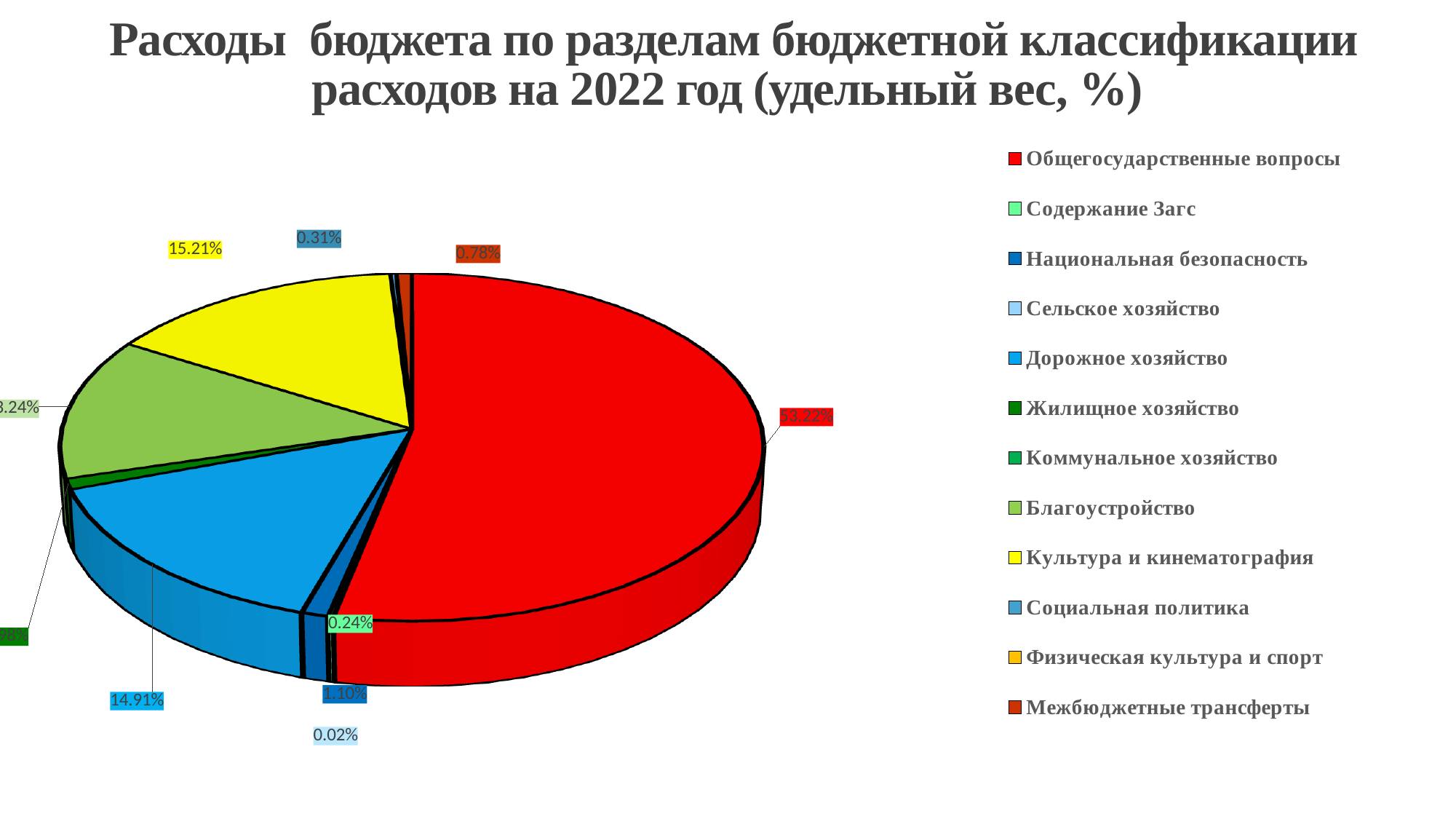
What share is shown for Дорожное хозяйство? 14.91% Which has the larger share, Культура и кинематография or Дорожное хозяйство? Культура и кинематография What kind of chart is shown on the slide? pie chart What colour is the slice for Общегосударственные вопросы? red What share is shown for Культура и кинематография? 15.21% What is the difference between the shares of Общегосударственные вопросы and Культура и кинематография? 38.01% What share of the budget expenses is Общегосударственные вопросы? 53.22% What share is shown for Национальная безопасность? 1.10% Which category has the largest share of the pie? Общегосударственные вопросы What share is shown for Межбюджетные трансферты? 0.78% How many categories does the legend list? 12 What share is shown for Сельское хозяйство? 0.02%